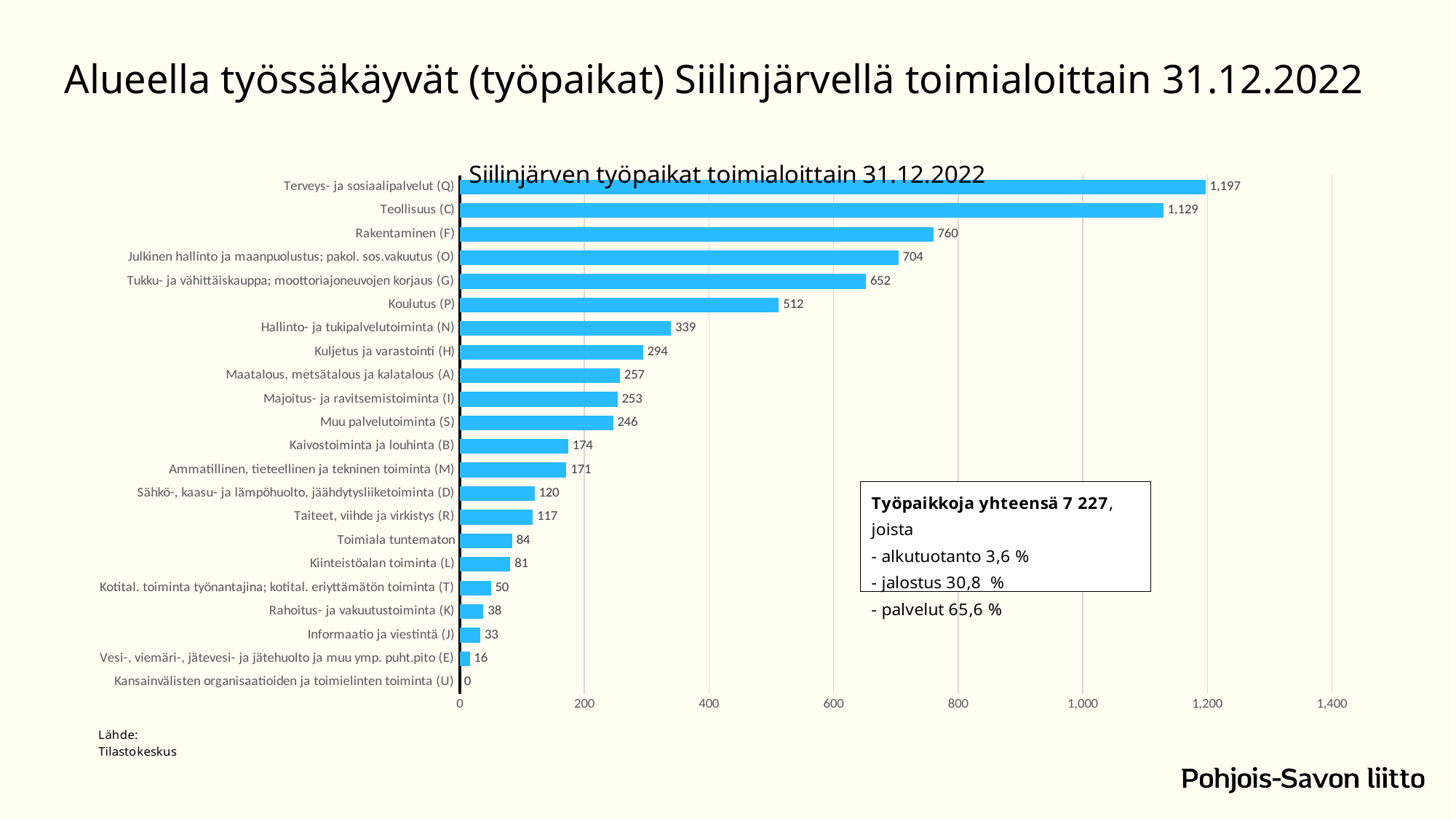
What kind of chart is shown on the slide? Bar chart Which category has the highest value? Terveys- ja sosiaalipalvelut (Q) Which category has the lowest value? Kansainvälisten organisaatioiden ja toimielinten toiminta (U) Which is larger, Kuljetus ja varastointi (H) or Hallinto- ja tukipalvelutoiminta (N)? Hallinto- ja tukipalvelutoiminta (N) Is the value for Tukku- ja vähittäiskauppa; moottoriajoneuvojen korjaus (G) greater or less than 600? greater How many categories are shown in the chart? 22 What is the difference between Terveys- ja sosiaalipalvelut (Q) and Teollisuus (C)? 68 What is the value for Teollisuus (C)? 1,129 What is the title of the chart? Siilinjärven työpaikat toimialoittain 31.12.2022 What is the value for Rahoitus- ja vakuutustoiminta (K)? 38 What is the difference between Rakentaminen (F) and Koulutus (P)? 248 What is the value for Koulutus (P)? 512